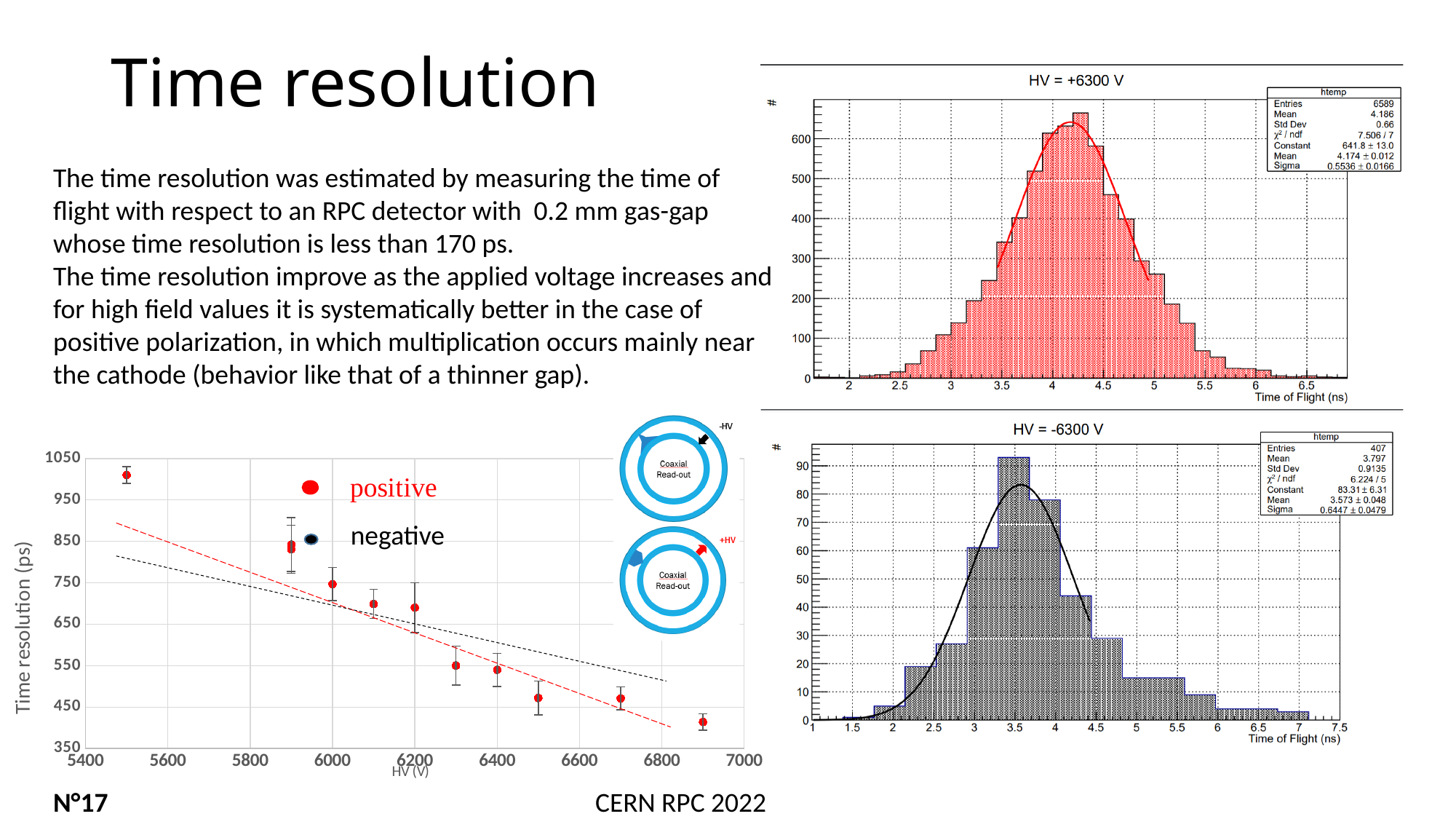
In the HV = -6300 V histogram, how many entries does the statistics box report? 407 What kind of chart is the top-right chart titled HV = +6300 V? histogram In the HV = +6300 V histogram, how many entries does the statistics box report? 6589 What is the difference in entries between the HV = +6300 V histogram and the HV = -6300 V histogram? 6182 Which histogram has more entries, HV = +6300 V or HV = -6300 V? HV = +6300 V How many series does the legend of the bottom-left time resolution chart list? 2 In the HV = +6300 V histogram, what Sigma value does the fit statistics box report? 0.5536 ± 0.0166 In the bottom-left chart, which colour represents the positive polarization series? red What is the y-axis label of the bottom-left chart? Time resolution (ps) In the bottom-left chart of time resolution versus HV, does the time resolution rise or fall as HV increases? fall In the bottom-left time resolution chart, is the value at HV = 6900 V greater or less than 450 ps? less In the bottom-left time resolution chart, is the value at HV = 5500 V greater or less than 950 ps? greater